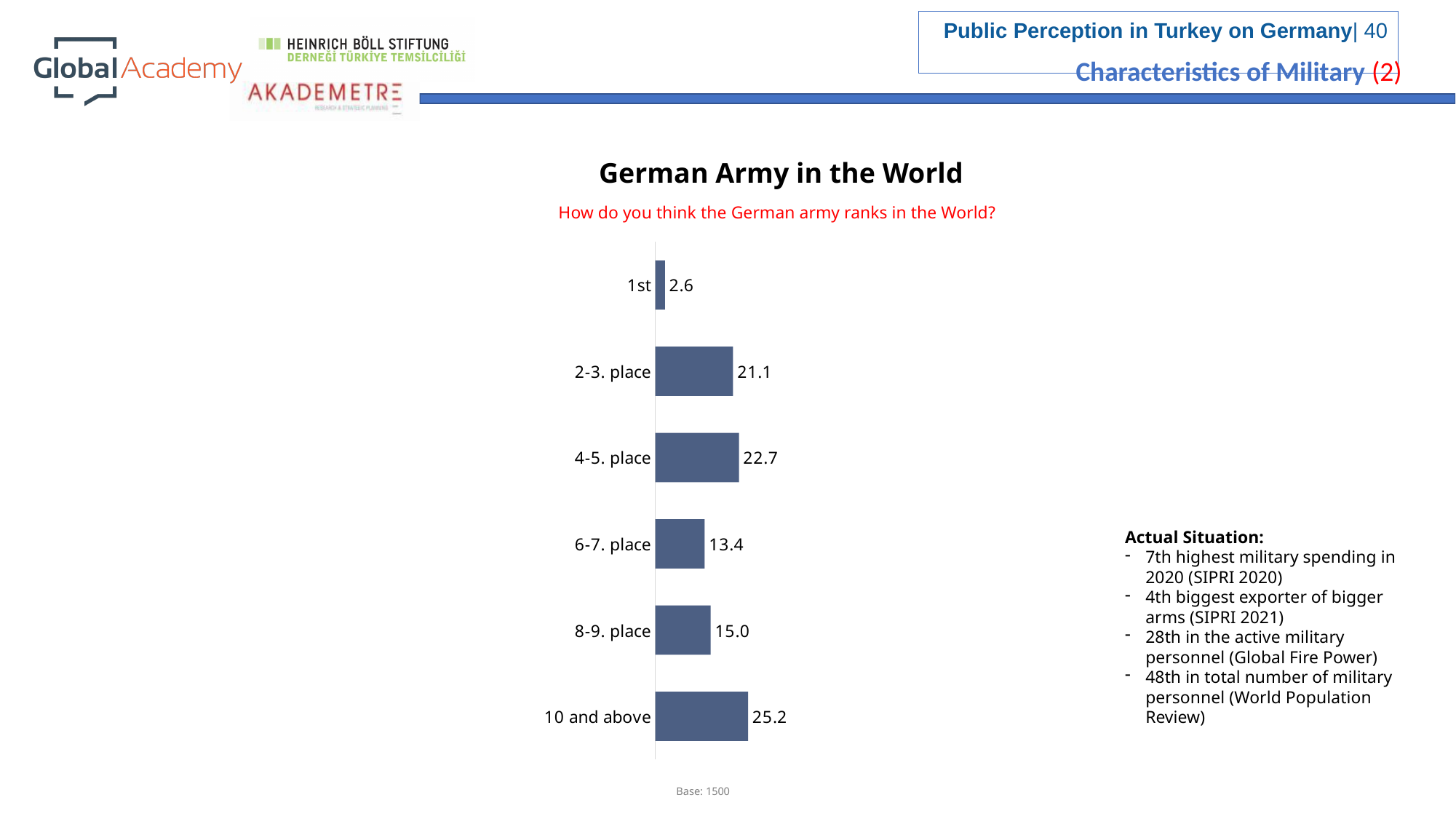
What is the difference between the values for "4-5. place" and "2-3. place"? 1.6 Which is larger, the value for "8-9. place" or the value for "6-7. place"? 8-9. place What is the value for "1st"? 2.6 What is the difference between the values for "10 and above" and "1st"? 22.6 What is the value for "6-7. place"? 13.4 What kind of chart is shown on the slide? Bar chart Which category has the highest value? 10 and above What is the value for "10 and above"? 25.2 How many categories are shown in the chart? 6 Which category has the lowest value? 1st What is the value for "2-3. place"? 21.1 What is the title of the chart? German Army in the World